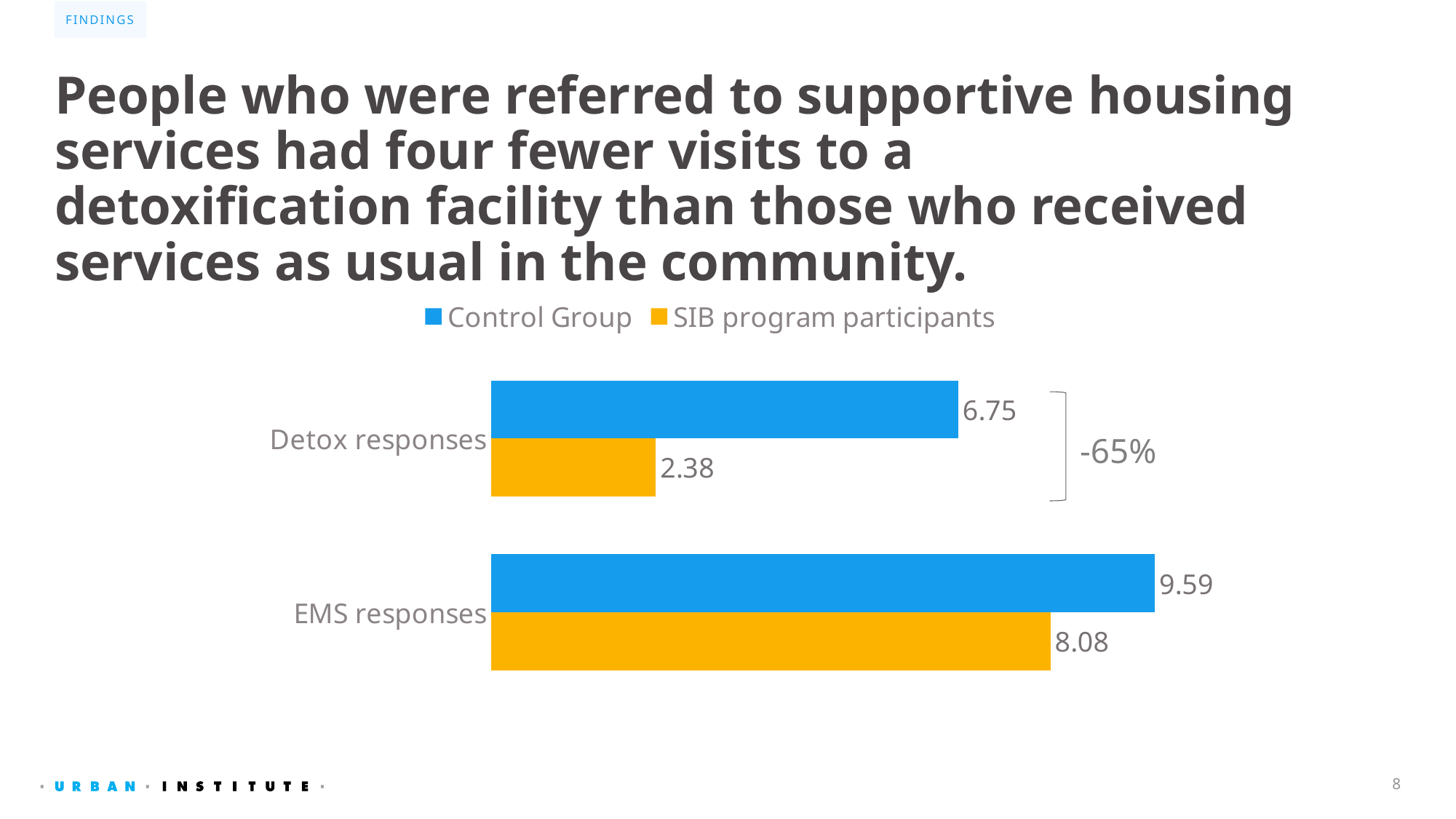
For EMS responses, which is larger: the Control Group value or the SIB program participants value? Control Group What is the SIB program participants value for EMS responses? 8.08 How many series does the legend list? 2 What is the SIB program participants value for Detox responses? 2.38 What is the Control Group value for Detox responses? 6.75 What is the difference between the Control Group and SIB program participants values for EMS responses? 1.51 Which category has the lowest SIB program participants value? Detox responses How many categories are shown in the chart? 2 What is the Control Group value for EMS responses? 9.59 What kind of chart is shown on the slide? Bar chart Which category has the highest Control Group value? EMS responses What is the difference between the Control Group and SIB program participants values for Detox responses? 4.37